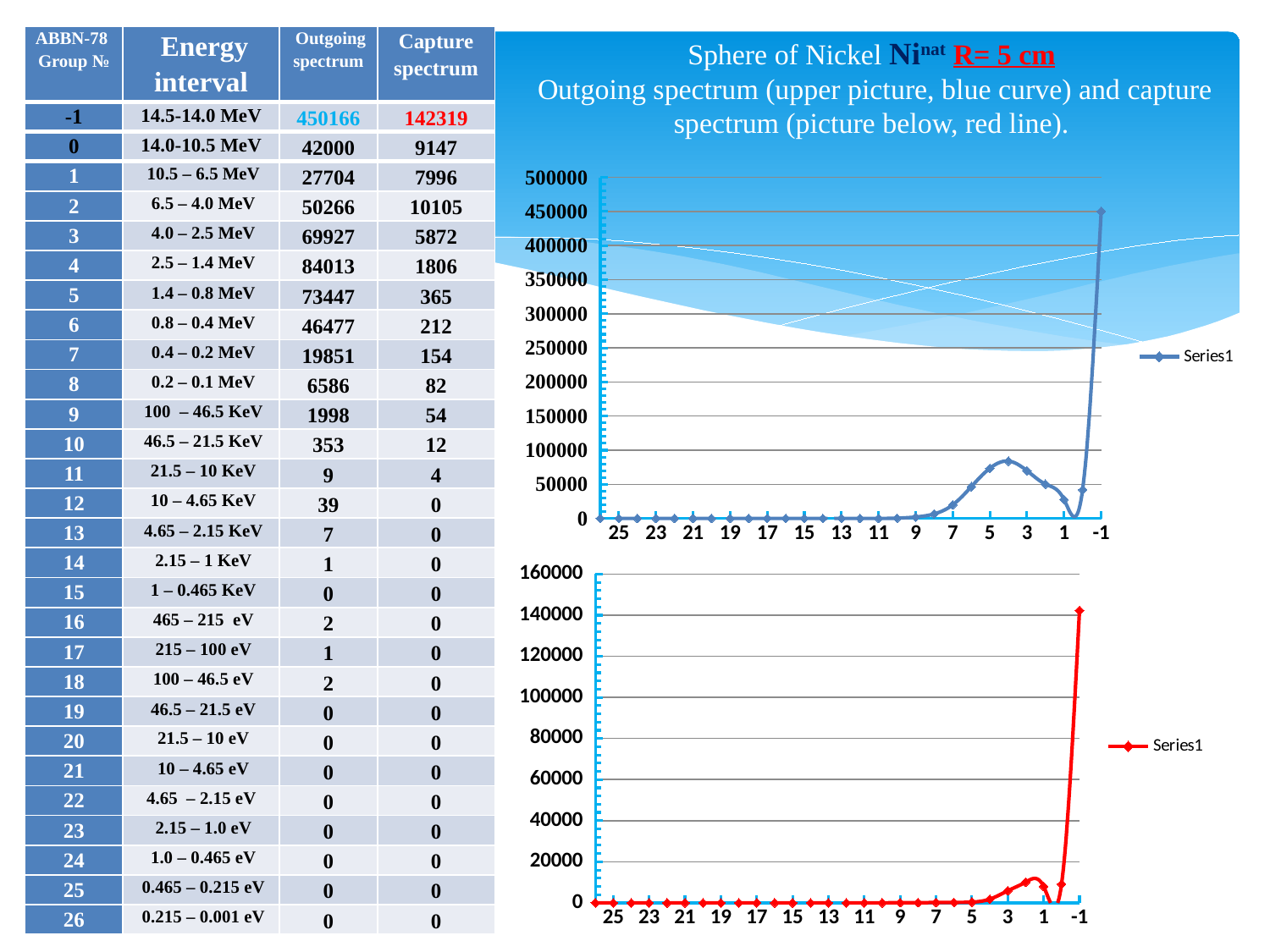
In the upper chart (outgoing spectrum), at which x-axis group does the curve reach its highest value? -1 In the lower chart, is the value at group -1 greater or less than 120000? greater What kind of chart is the upper chart on the slide? line chart How many series does the legend of the lower chart list? 1 In the upper chart, which is larger: the value at group 4 or the value at group 8? group 4 In the lower chart, is the value at group 1 greater or less than 20000? less In the upper chart, do the values overall rise or fall moving along the x axis from left (25) to right (-1)? rise In the upper chart, is the value at group -1 greater or less than 400000? greater What kind of chart is the lower chart on the slide? line chart What colour is the line in the lower chart? red In the lower chart (capture spectrum), at which x-axis group does the curve reach its highest value? -1